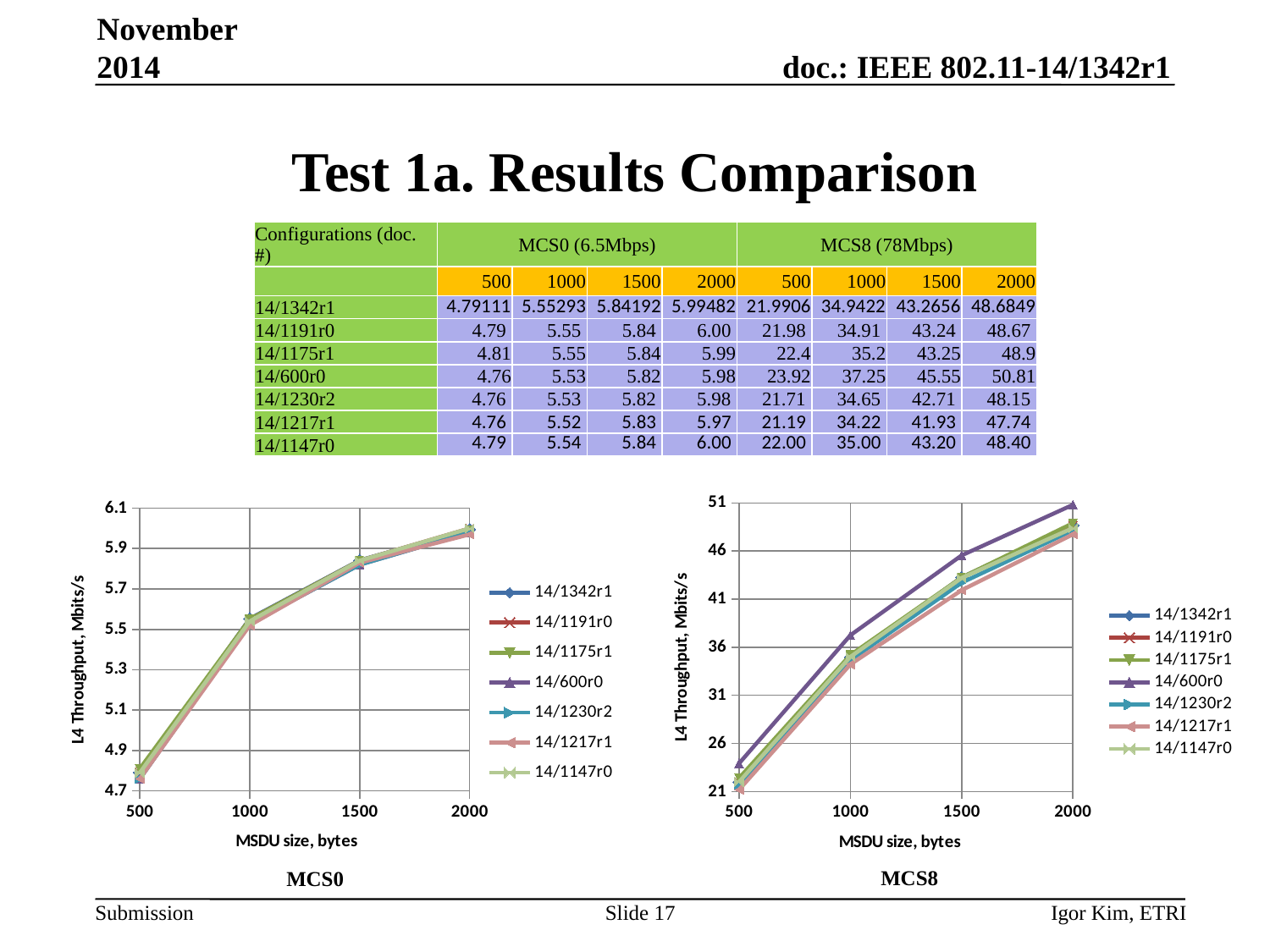
In the MCS8 chart, which is larger at 1000 bytes: the value for 14/600r0 or the value for 14/1217r1? 14/600r0 In the MCS8 chart, is the value for 14/600r0 at 1500 bytes greater or less than 41? greater In the MCS0 chart, is the value for 14/1342r1 at 2000 bytes greater or less than 5.9? greater In the MCS8 chart, do the throughput values rise or fall as MSDU size increases from 500 to 2000 bytes? rise In the MCS0 chart, is the value for 14/1342r1 at 500 bytes greater or less than 4.9? less What kind of chart is the MCS0 chart on the left? line chart In the MCS8 chart, what is the throughput of 14/600r0 at an MSDU size of 2000 bytes, as given in the table? 50.81 How many series does the legend of the MCS8 chart list? 7 How many MSDU size points are plotted along the x axis of the MCS0 chart? 4 What is the y-axis title of the MCS8 chart? L4 Throughput, Mbits/s In the MCS8 chart, which series has the highest throughput at an MSDU size of 2000 bytes? 14/600r0 In the MCS8 chart, what is the difference between the 14/600r0 and 14/1217r1 values at 2000 bytes, using the table values? 3.07